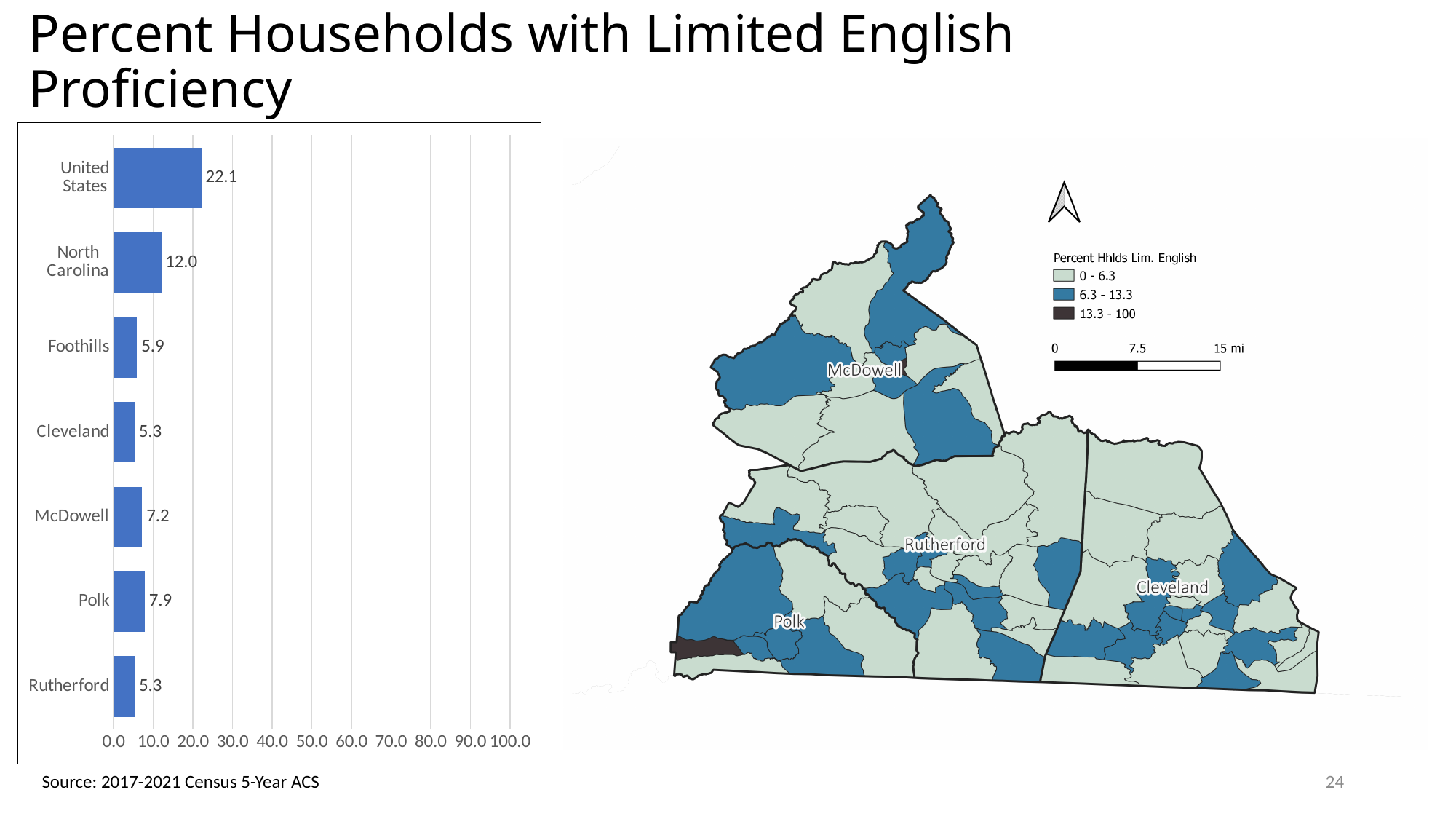
What is the difference between the Polk and Foothills values in the bar chart? 2.0 What is the value for Polk in the bar chart? 7.9 What kind of chart is shown on the left of the slide? bar chart Which category has the highest value in the bar chart? United States What is the value for McDowell in the bar chart? 7.2 What is the difference between the United States and North Carolina values in the bar chart? 10.1 Is the value for North Carolina in the bar chart greater or less than 10.0? greater What is the value for North Carolina in the bar chart? 12.0 Which is larger in the bar chart, the value for Polk or the value for McDowell? Polk How many categories are shown in the bar chart? 7 What is the value for the United States in the bar chart? 22.1 What is the maximum value shown on the x axis of the bar chart? 100.0